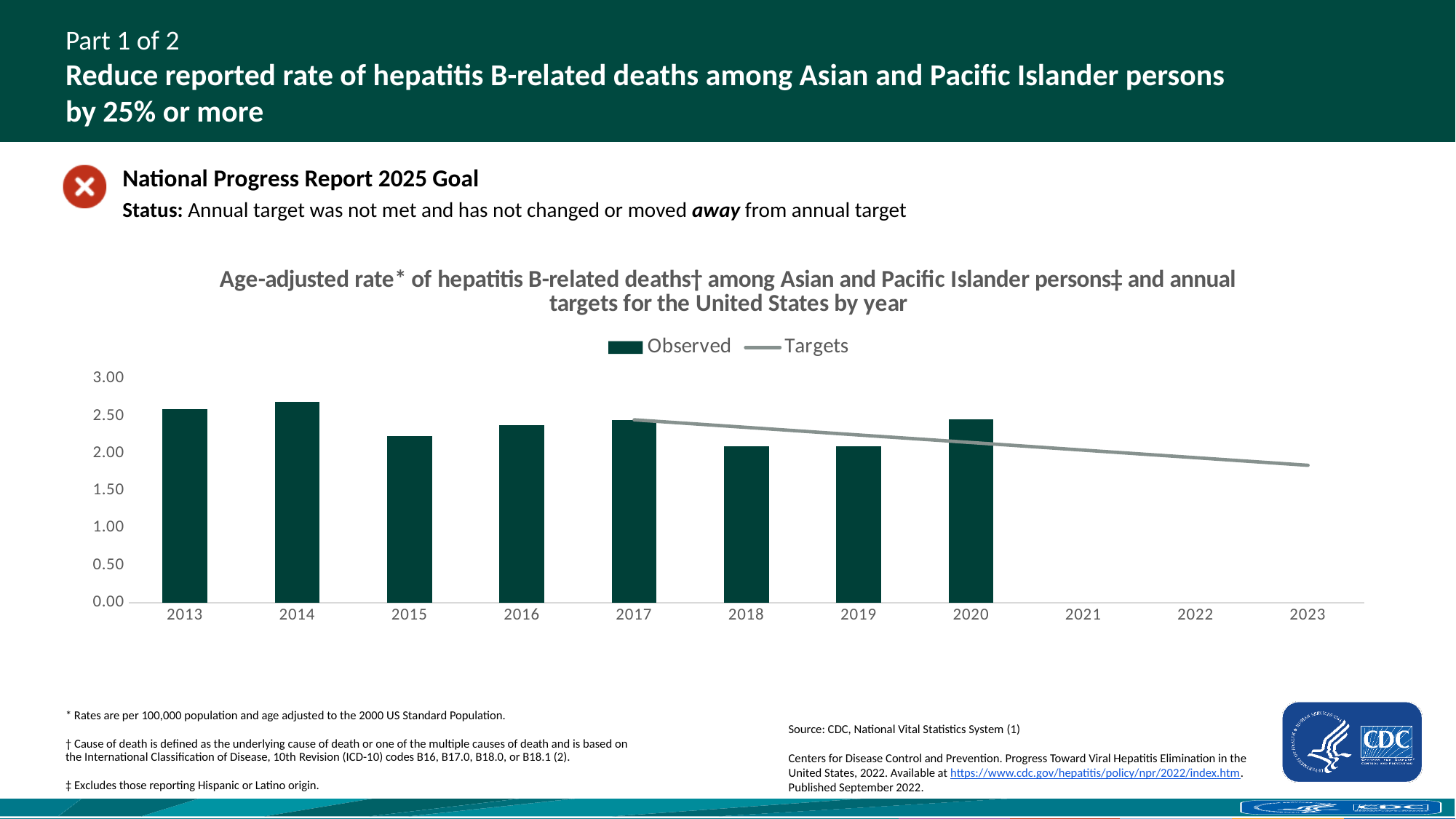
What are the two series named in the chart legend? Observed and Targets Is the Observed value for 2013 greater or less than 2.00? greater Which is larger, the Observed value for 2014 or for 2015? 2014 How many years are labelled on the x axis of the chart? 11 What kind of chart is shown on the slide? combination bar and line chart Is the Observed value for 2014 greater or less than 2.50? greater Which year has the highest Observed bar? 2014 Which is larger, the Observed value for 2013 or for 2018? 2013 How many years have an Observed bar plotted in the chart? 8 How many series does the chart legend list? 2 Is the Observed value for 2015 greater or less than 2.50? less Does the Targets line rise or fall from 2017 to 2023? fall